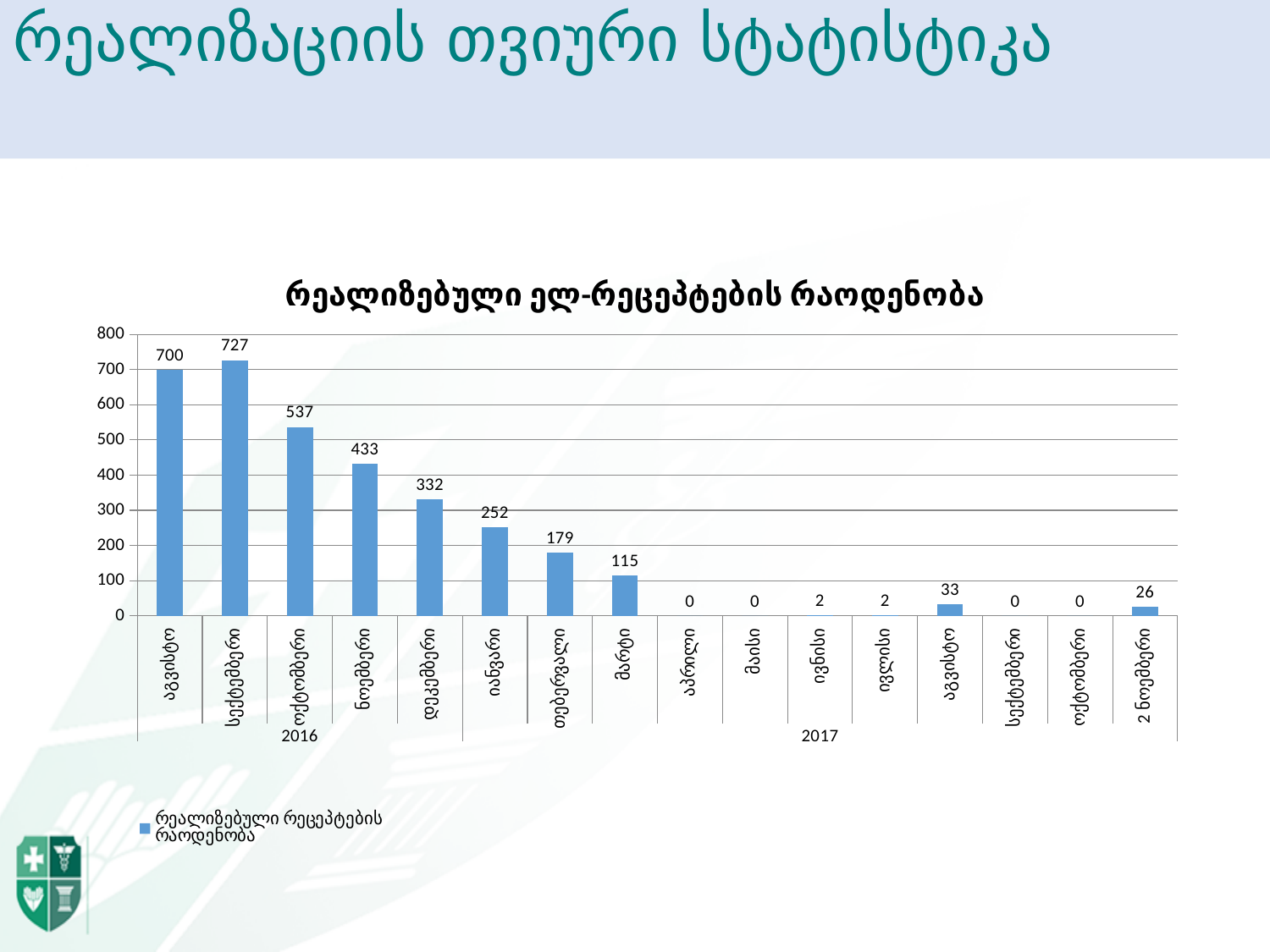
What kind of chart is this? bar chart Which category has the highest value? სექტემბერი 2016 What is the value for 2 ნოემბერი 2017? 26 What is the value for სექტემბერი 2016? 727 What is the value for დეკემბერი 2016? 332 What is the difference between the values for აგვისტო 2016 and სექტემბერი 2016? 27 What is the value for აგვისტო 2017? 33 How many categories (bars) are shown on the x axis? 16 Which is larger, the value for იანვარი 2017 or the value for თებერვალი 2017? იანვარი 2017 What is the difference between the values for ოქტომბერი 2016 and ნოემბერი 2016? 104 How many series does the legend list? 1 Do the values rise or fall from სექტემბერი 2016 to მარტი 2017? fall